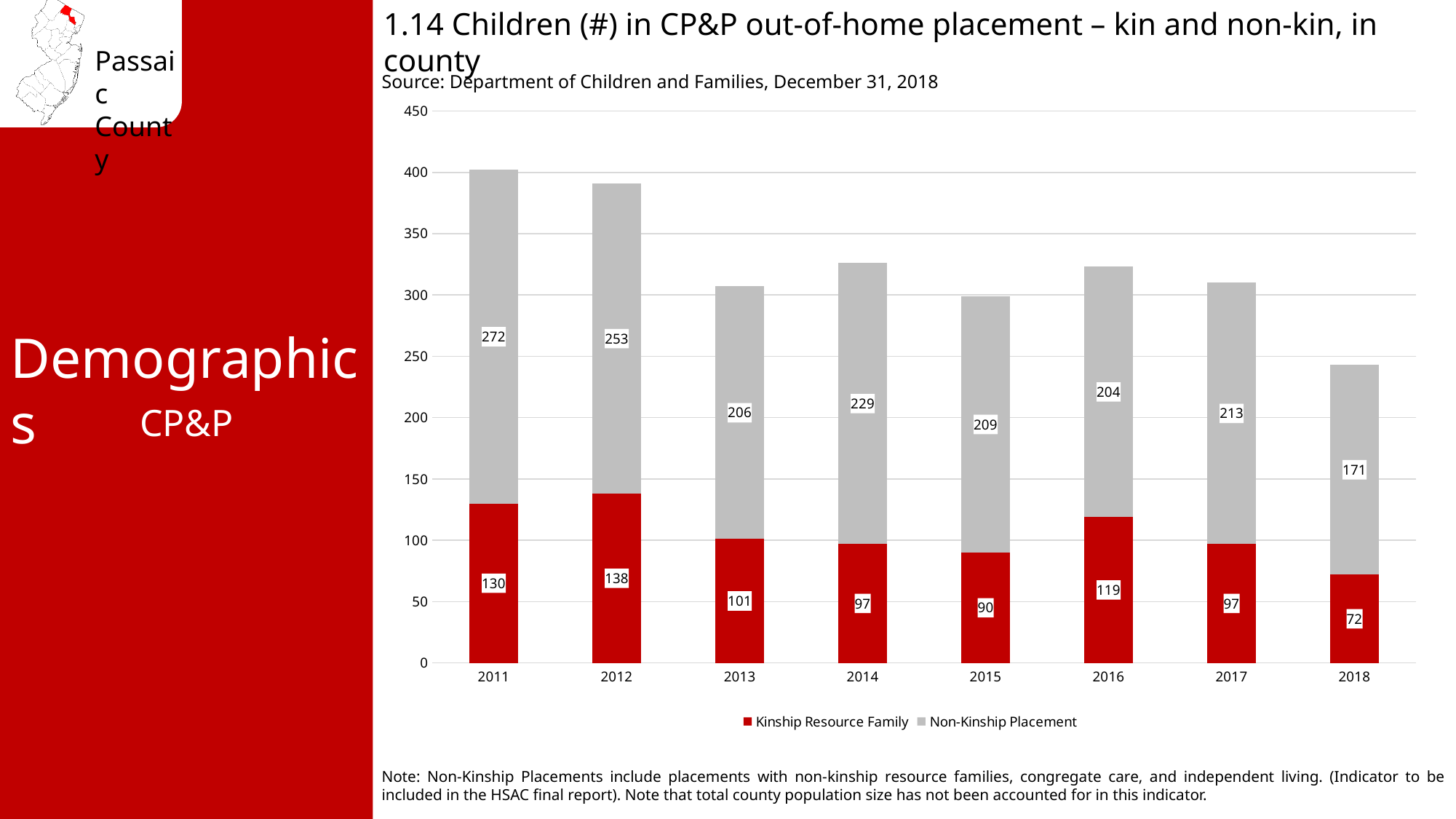
What is the total of the stacked bar for 2018? 243 Which is larger, the Kinship Resource Family value for 2016 or for 2017? 2016 What is the difference between the Non-Kinship Placement values for 2011 and 2012? 19 How many years are shown on the x axis? 8 What kind of chart is shown? Stacked bar chart How many series does the legend list? 2 What is the Non-Kinship Placement value for 2014? 229 Which year has the highest Non-Kinship Placement value? 2011 Which year has the lowest Kinship Resource Family value? 2018 What is the total of the stacked bar for 2013? 307 What is the Kinship Resource Family value for 2018? 72 What is the Kinship Resource Family value for 2012? 138